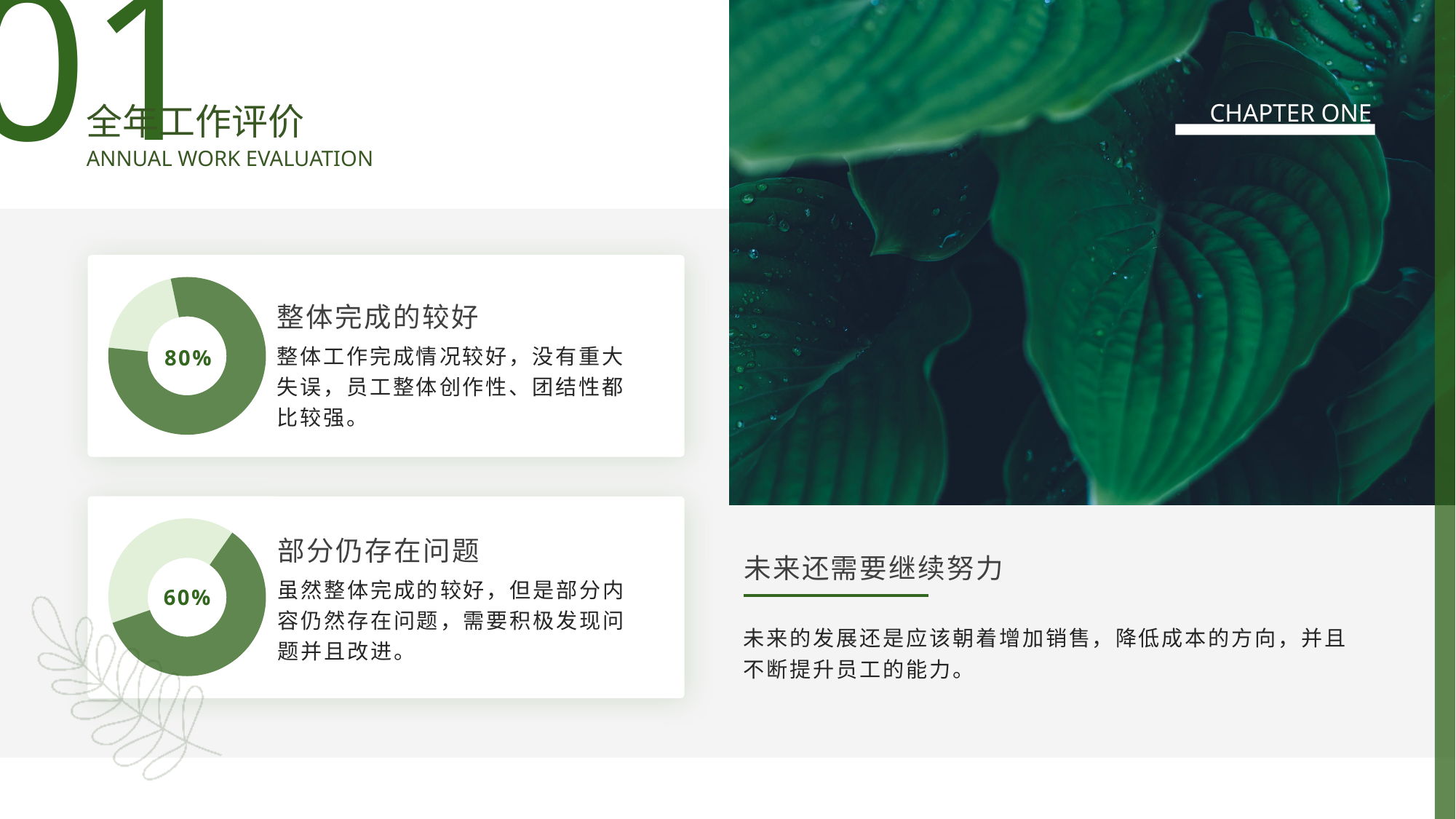
What kind of chart is used next to "整体完成的较好"? Donut (pie) chart In the upper donut chart, what share does the dark green slice represent? 80% How many donut charts are on the slide? 2 What kind of chart is used next to "部分仍存在问题"? Donut (pie) chart What value is shown in the centre of the donut chart next to "部分仍存在问题"? 60% What value is shown in the centre of the donut chart next to "整体完成的较好"? 80% Is the value in the lower donut chart (next to "部分仍存在问题") greater or less than 50%? greater How many slices does the donut chart next to "整体完成的较好" have? 2 What colour is the larger slice in the donut chart next to "整体完成的较好"? Dark green In the lower donut chart, what share does the dark green slice represent? 60% What is the difference between the percentage in the upper donut chart (80%) and the lower donut chart (60%)? 20% Which chart shows the larger percentage, the one next to "整体完成的较好" or the one next to "部分仍存在问题"? 整体完成的较好